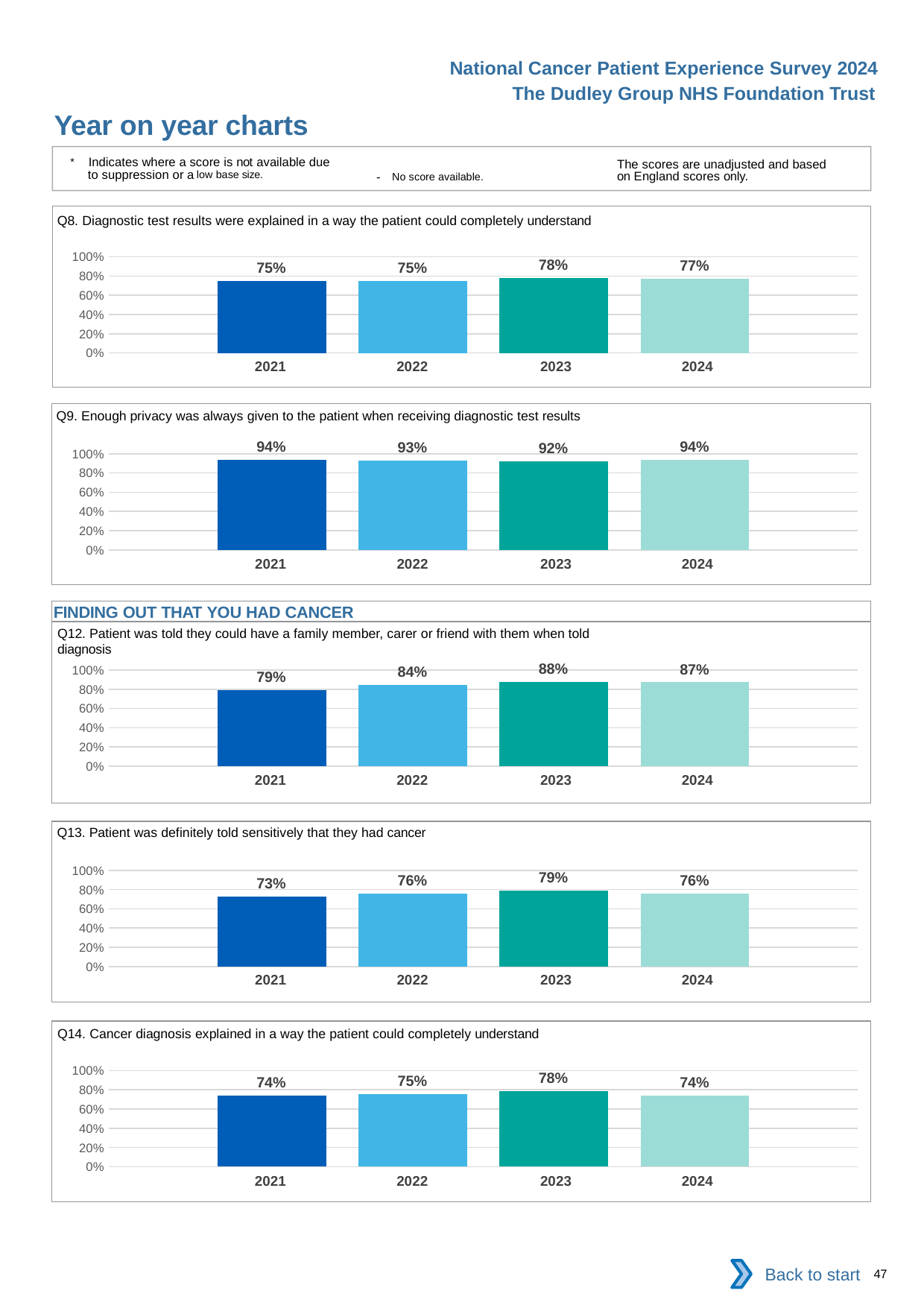
What is the section heading shown above the Q12 chart? FINDING OUT THAT YOU HAD CANCER In the Q12 chart, is the value for 2022 larger or smaller than the value for 2024? smaller In the Q14 chart, what is the difference between the 2023 and 2022 values? 3 percentage points In the Q12 chart, what is the difference between the 2023 and 2021 values? 9 percentage points In the Q13 chart, is the value for 2021 greater or less than 80%? less What kind of chart is the Q9 chart? bar chart In the Q13 chart, which year has the highest value? 2023 In the Q14 chart, what is the value for 2024? 74% In the Q8 chart, how many years are plotted? 4 In the Q9 chart, what is the value for 2022? 93% In the Q9 chart, which year has the lowest value? 2023 In the Q8 chart, what is the value for 2023? 78%